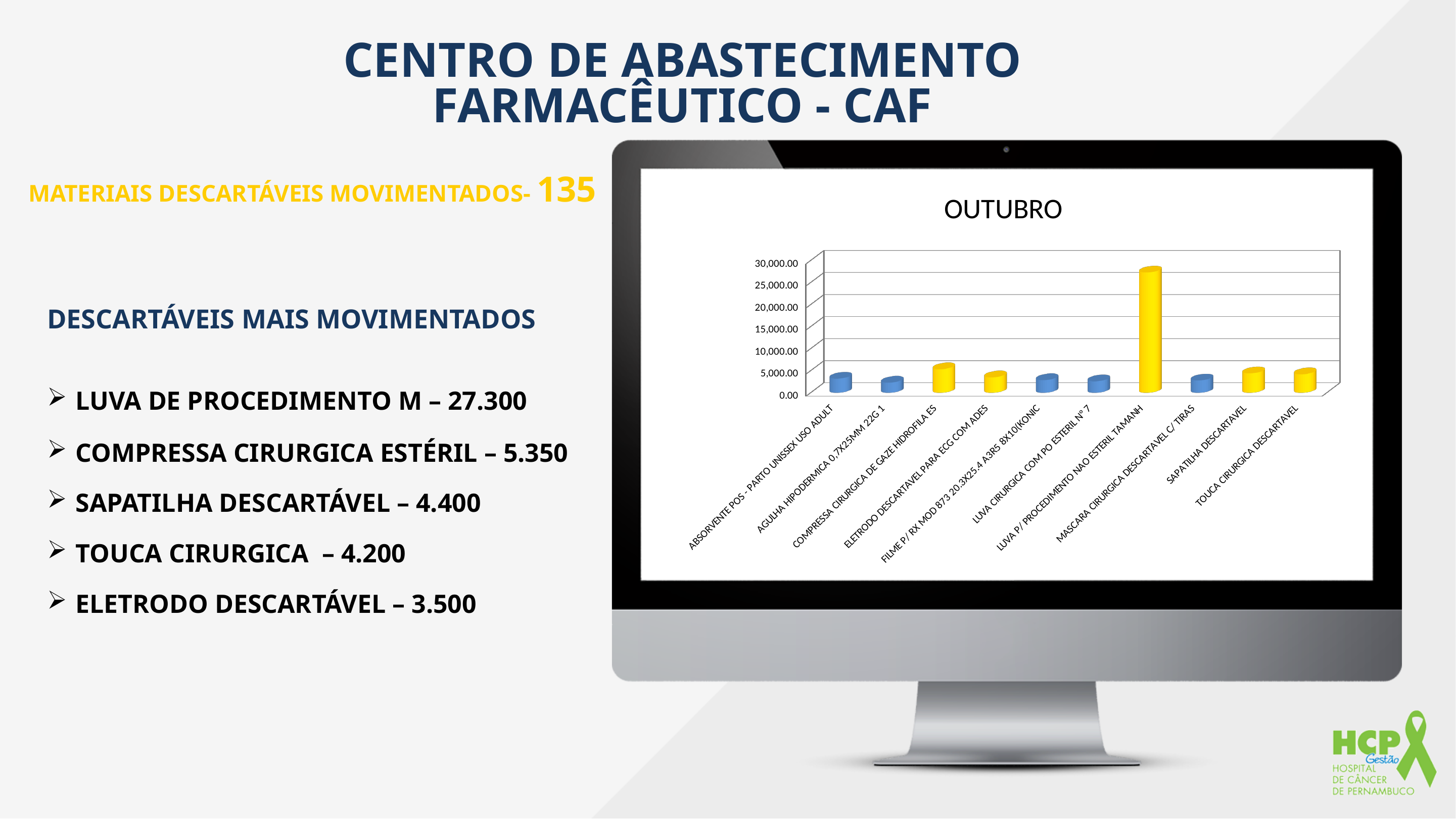
In the OUTUBRO chart, which is larger: the bar for COMPRESSA CIRURGICA DE GAZE HIDROFILA ES or the bar for AGULHA HIPODERMICA 0,7X25MM 22G 1? COMPRESSA CIRURGICA DE GAZE HIDROFILA ES In the OUTUBRO chart, is the value for COMPRESSA CIRURGICA DE GAZE HIDROFILA ES greater or less than 10,000.00? less What kind of chart is shown on the monitor? bar chart How many bars in the OUTUBRO chart are coloured yellow? 5 What is the highest value shown on the vertical axis of the OUTUBRO chart? 30,000.00 In the OUTUBRO chart, is the value for LUVA P/ PROCEDIMENTO NAO ESTERIL TAMANH greater or less than 25,000.00? greater How many categories are plotted in the OUTUBRO chart? 10 In the OUTUBRO chart, which is larger: the bar for LUVA P/ PROCEDIMENTO NAO ESTERIL TAMANH or the bar for SAPATILHA DESCARTAVEL? LUVA P/ PROCEDIMENTO NAO ESTERIL TAMANH In the OUTUBRO chart, is the value for ABSORVENTE POS - PARTO UNISSEX USO ADULT greater or less than 5,000.00? less What is the title of the chart shown on the monitor? OUTUBRO Which category has the highest bar in the OUTUBRO chart? LUVA P/ PROCEDIMENTO NAO ESTERIL TAMANH